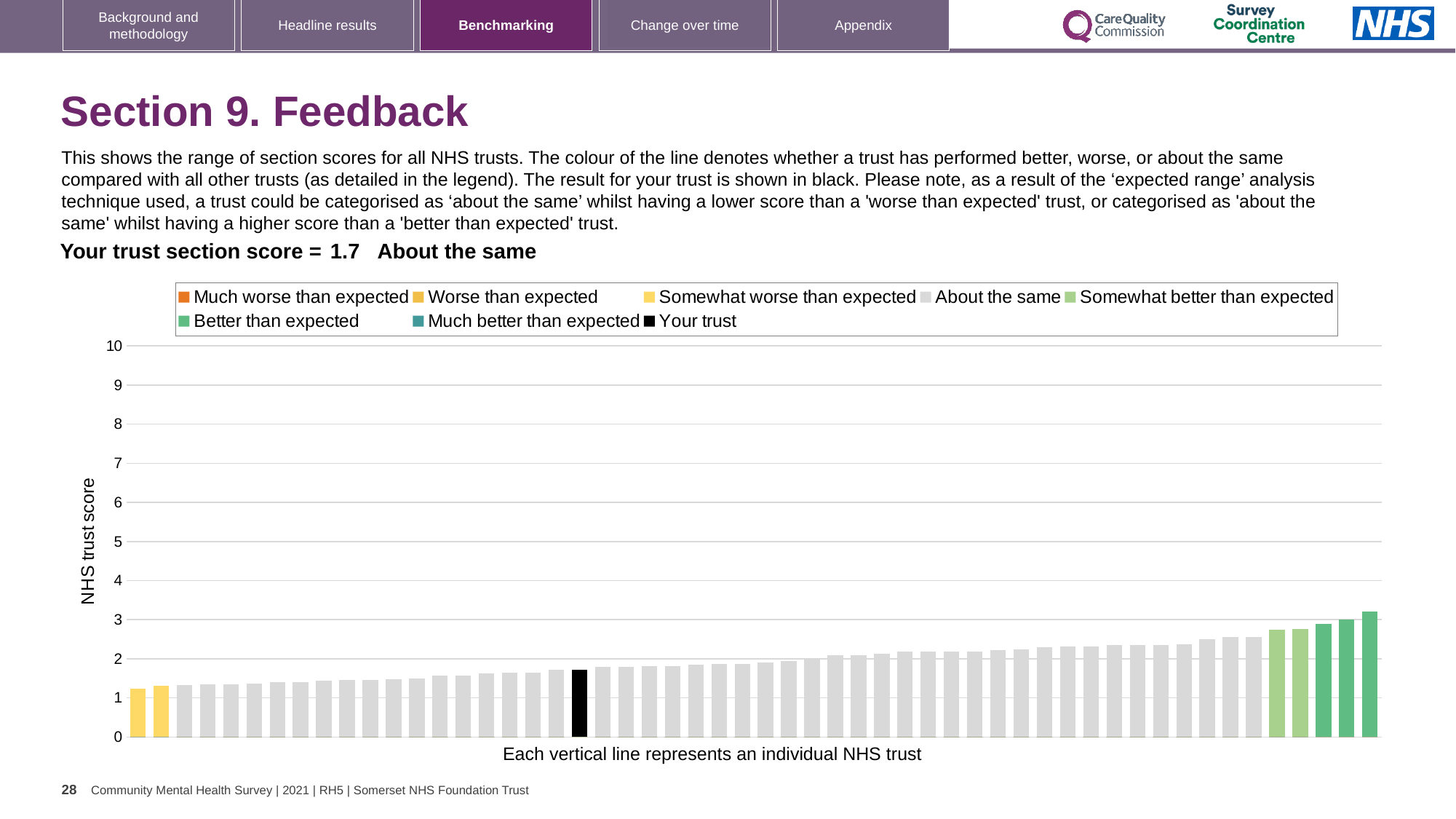
What is the section score for your trust shown on the slide? 1.7 How many bars are coloured dark green (Better than expected)? 3 How many entries does the chart legend list? 8 What colour is the bar representing your trust? black Is the value of the black 'Your trust' bar greater or less than 2? less Do the bar values rise or fall from left to right along the x axis? rise Is the value of the tallest bar in the chart greater or less than 3? greater Is the value of the tallest bar in the chart greater or less than 4? less What kind of chart is shown on the slide? bar chart What is the label on the vertical axis of the chart? NHS trust score How many bars are coloured yellow (Somewhat worse than expected)? 2